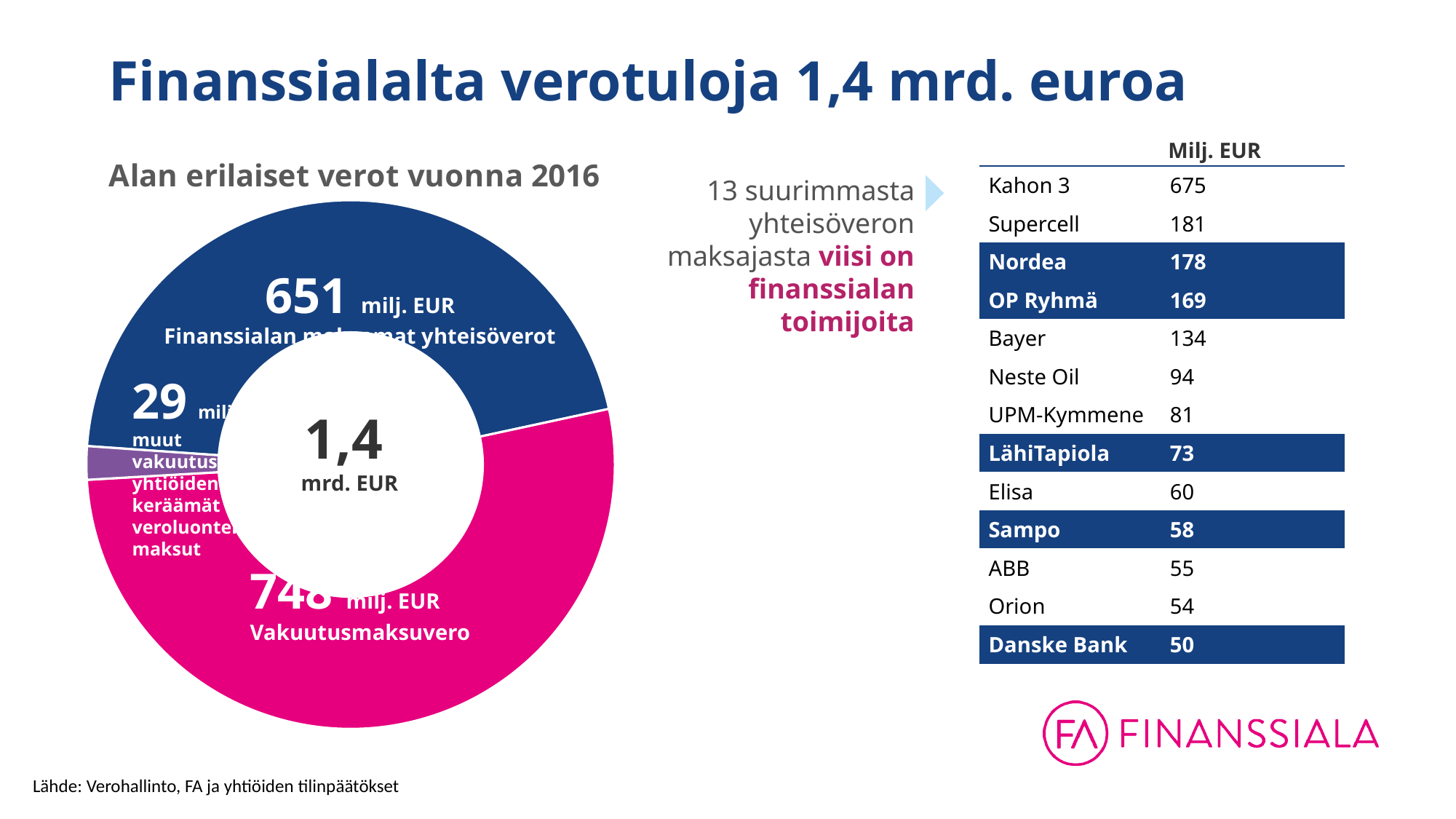
In the pie chart, what is the value for Vakuutusmaksuvero? 748 milj. EUR Which slice of the pie chart is the smallest? Muut vakuutusyhtiöiden keräämät veroluonteiset maksut In the pie chart, what is the value for muut vakuutusyhtiöiden keräämät veroluonteiset maksut? 29 milj. EUR What kind of chart is shown on the left of the slide under 'Alan erilaiset verot vuonna 2016'? Doughnut chart In the pie chart, which is larger: Vakuutusmaksuvero or Finanssialan maksamat yhteisöverot? Vakuutusmaksuvero How many slices does the pie chart have? 3 Which slice of the pie chart is the largest? Vakuutusmaksuvero In the pie chart, what is the value for Finanssialan maksamat yhteisöverot? 651 milj. EUR What colour is the Vakuutusmaksuvero slice in the pie chart? Pink (magenta) What total is shown in the centre of the pie chart? 1,4 mrd. EUR What is the title of the pie chart? Alan erilaiset verot vuonna 2016 In the pie chart, how much larger is Vakuutusmaksuvero than Finanssialan maksamat yhteisöverot? 97 milj. EUR